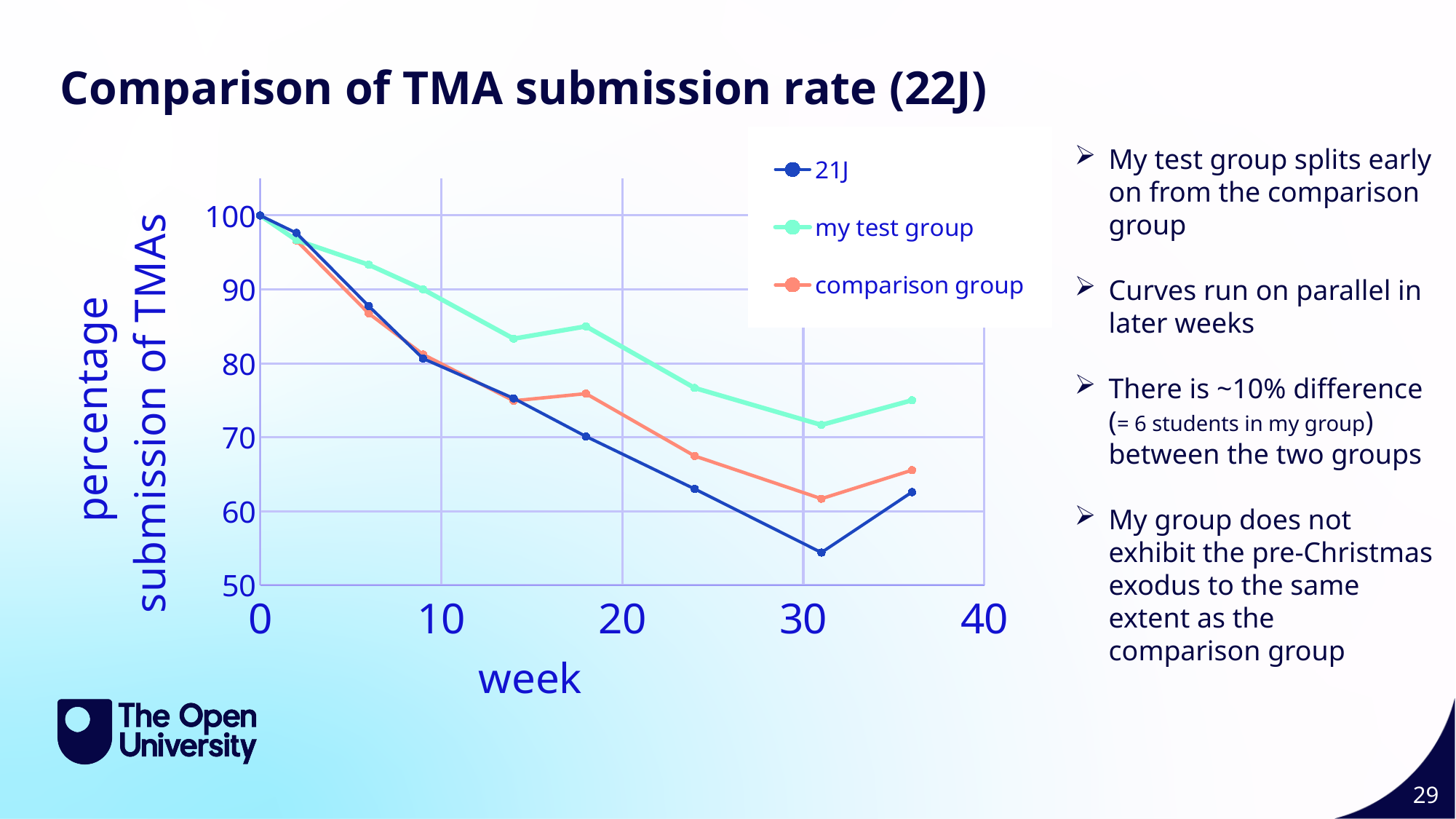
Is the value for my test group at week 31 greater or less than 70? greater Which series has the highest value at week 36? my test group Is the value for my test group at week 18 greater or less than 80? greater Is the value for 21J at week 31 greater or less than 60? less Which series has the lowest value at week 31? 21J At week 24, which series has the larger value: 21J or the comparison group? comparison group What is the label of the x axis? week How many series does the legend list? 3 What is the value for the 21J series at week 0? 100 What kind of chart is shown on the slide? line chart Do the values for the 21J series generally rise or fall as the week increases? fall